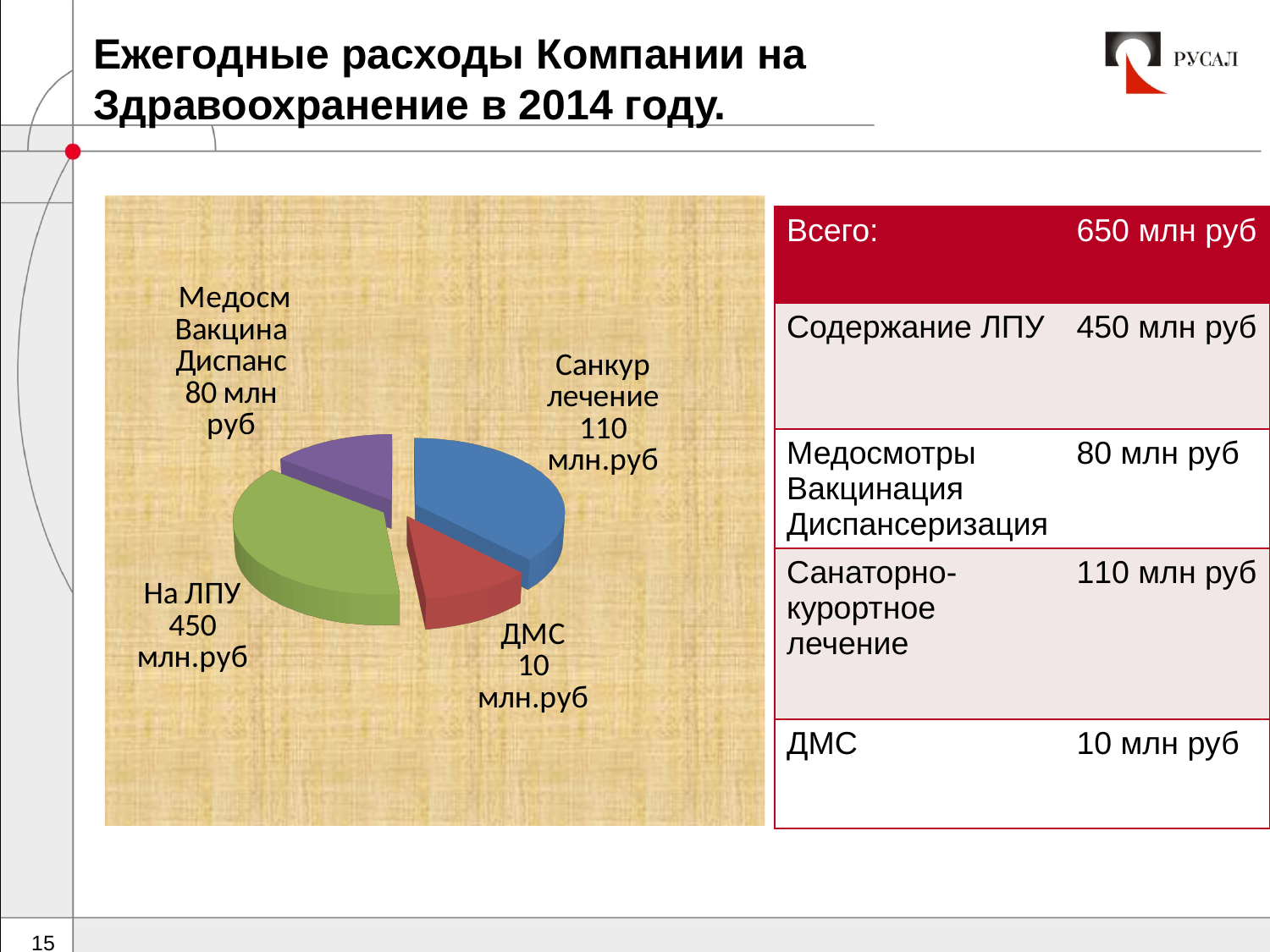
What kind of chart is shown on the slide? Pie chart What is the difference between the 'На ЛПУ' and 'Санкур лечение' values in the pie chart? 340 млн.руб What is the value of the 'Медосм Вакцина Диспанс' slice in the pie chart? 80 млн руб What is the value of the 'Санкур лечение' slice in the pie chart? 110 млн.руб What is the total of all four slices in the pie chart? 650 млн руб What is the value of the 'На ЛПУ' slice in the pie chart? 450 млн.руб How many slices does the pie chart have? 4 Which is larger in the pie chart: 'Санкур лечение' or 'Медосм Вакцина Диспанс'? Санкур лечение Which slice of the pie chart is the smallest? ДМС What colour is the 'На ЛПУ' slice in the pie chart? Green What is the value of the 'ДМС' slice in the pie chart? 10 млн.руб Which slice of the pie chart is the largest? На ЛПУ